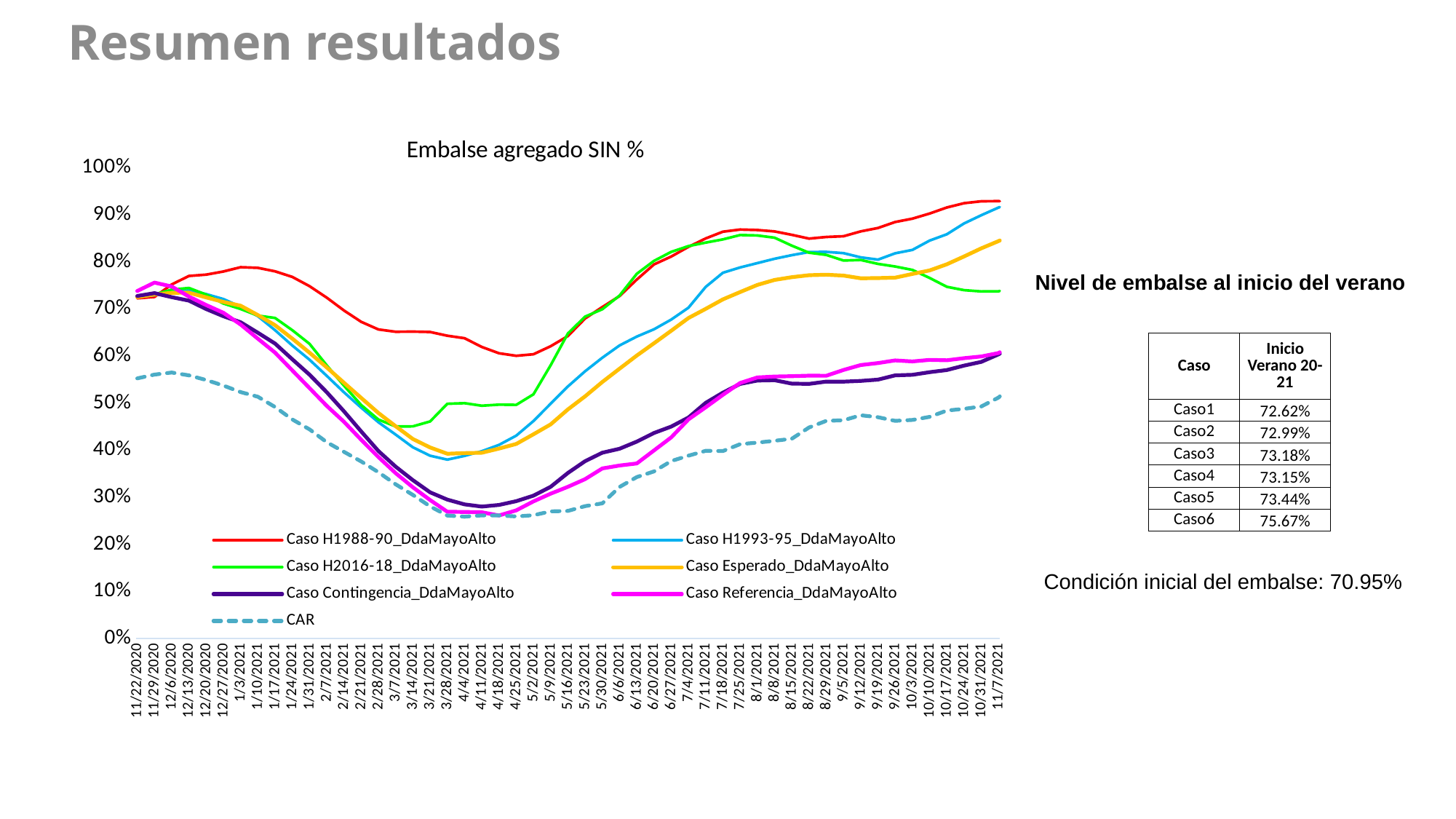
How many series does the chart legend list? 7 Is the value for Caso Esperado_DdaMayoAlto at 11/7/2021 greater or less than 80%? greater Is the value for Caso H1988-90_DdaMayoAlto at 11/7/2021 greater or less than 90%? greater Which series has the highest value at 11/7/2021? Caso H1988-90_DdaMayoAlto Which series in the chart is drawn with a dashed line? CAR What kind of chart is shown on the slide? Line chart Does the CAR series rise or fall between 11/22/2020 and 4/18/2021? Fall Is the value for CAR at 11/22/2020 greater or less than 50%? greater At 11/7/2021, which is higher: Caso H1988-90_DdaMayoAlto or Caso H2016-18_DdaMayoAlto? Caso H1988-90_DdaMayoAlto Which series has the lowest value at 11/7/2021? CAR What is the title of the chart? Embalse agregado SIN %